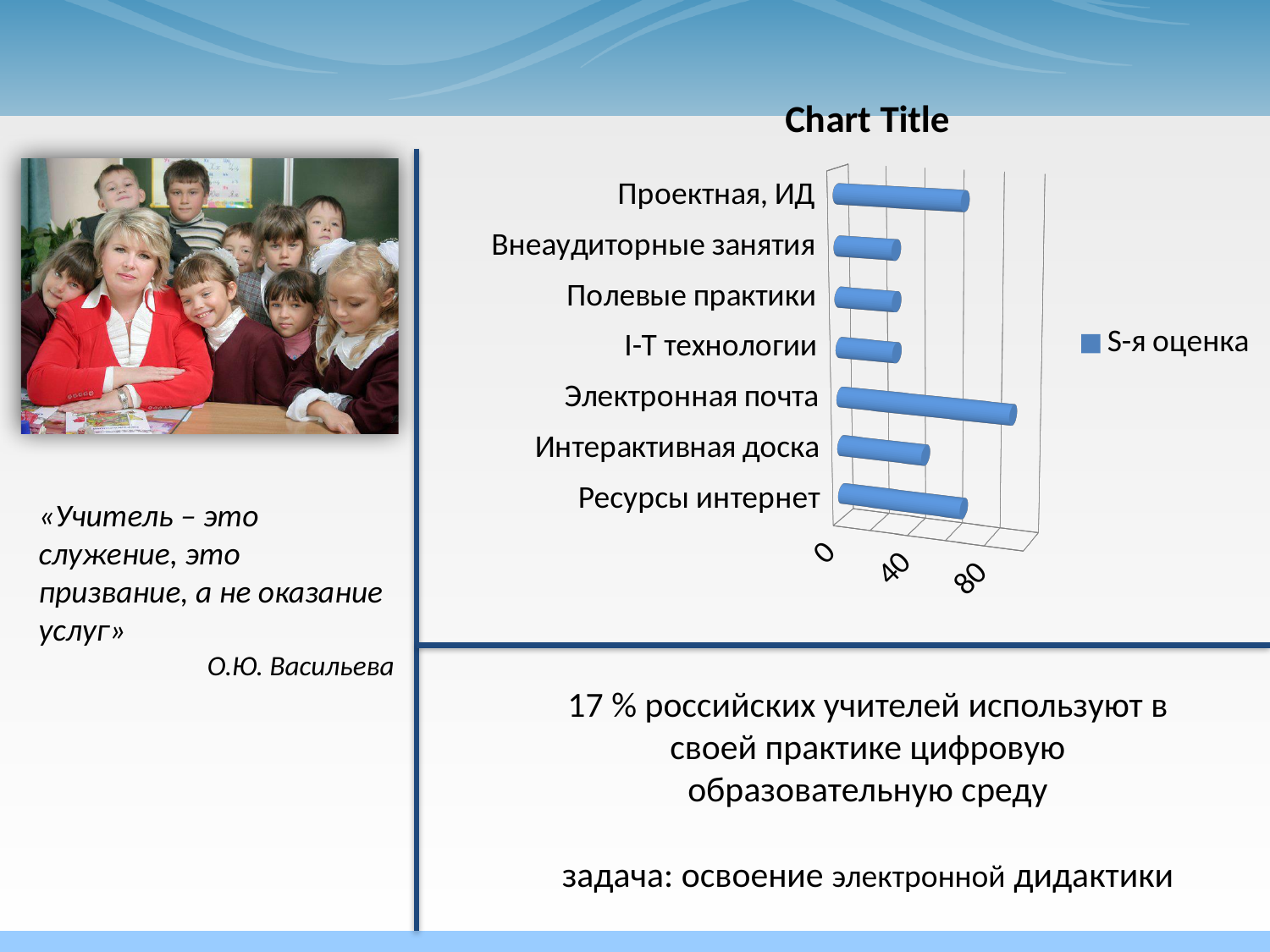
How many categories are plotted in the chart? 7 Which category has the highest value in the chart? Электронная почта How many series does the chart legend list? 1 Is the value for Электронная почта greater or less than 80? greater Is the value for Проектная, ИД greater or less than 40? greater Which is larger, the value for Проектная, ИД or the value for Внеаудиторные занятия? Проектная, ИД What is the title of the chart? Chart Title Which is larger, the value for Ресурсы интернет or the value for Полевые практики? Ресурсы интернет Which is larger, the value for Электронная почта or the value for Интерактивная доска? Электронная почта What is the name of the series shown in the chart legend? S-я оценка What kind of chart is shown on the slide? bar chart